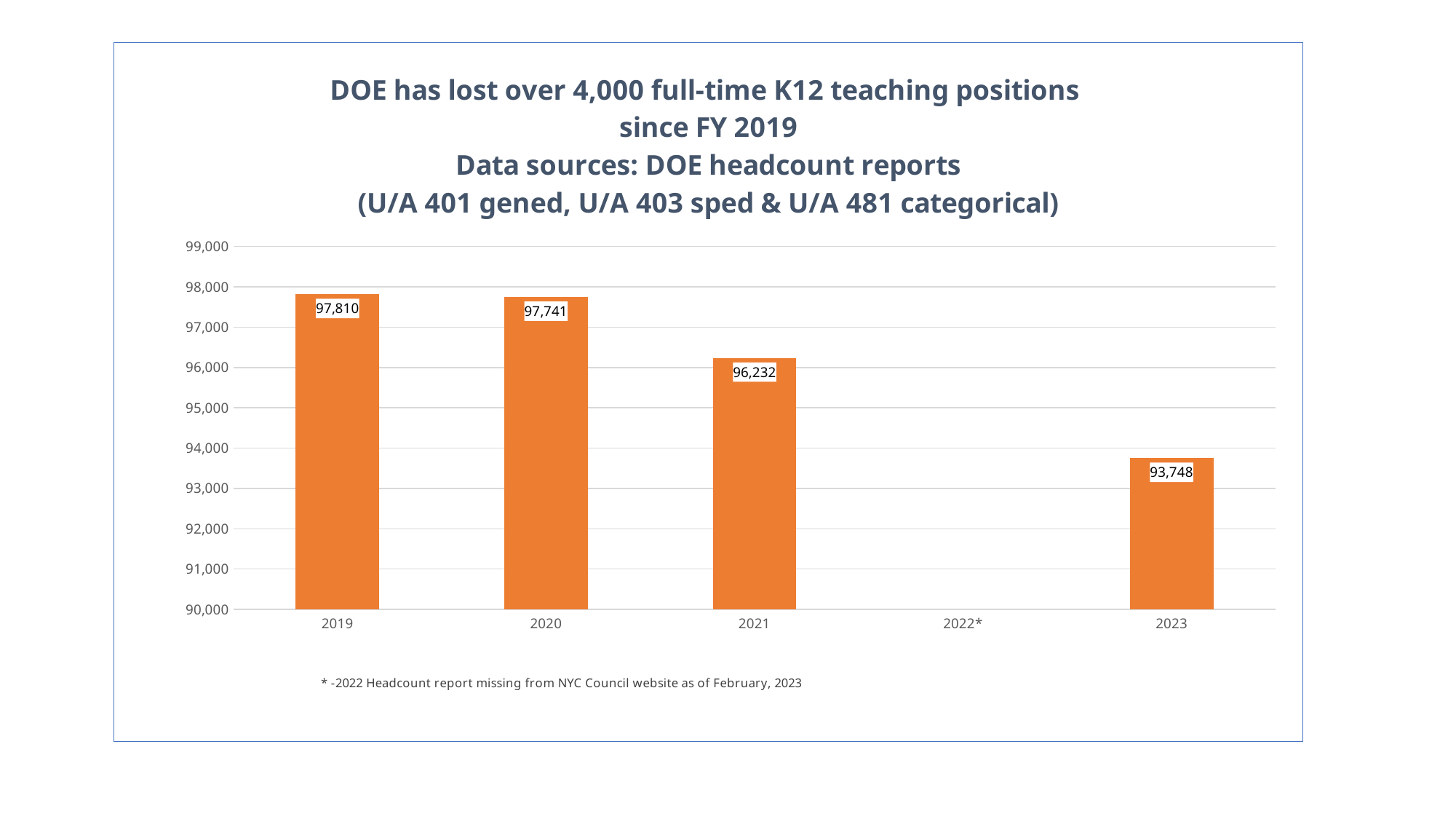
What is the value for 2021? 96,232 How many year categories are shown on the x axis? 5 What is the difference between the values for 2020 and 2021? 1,509 What kind of chart is this? bar chart What is the value for 2019? 97,810 Do the values rise or fall from 2019 to 2023? fall What is the value for 2023? 93,748 Is the value for 2020 greater or less than 97,000? greater Which year has the highest value? 2019 What is the difference between the values for 2019 and 2023? 4,062 Which year has the lowest value among those with a bar? 2023 Which is larger, the value for 2021 or the value for 2023? 2021